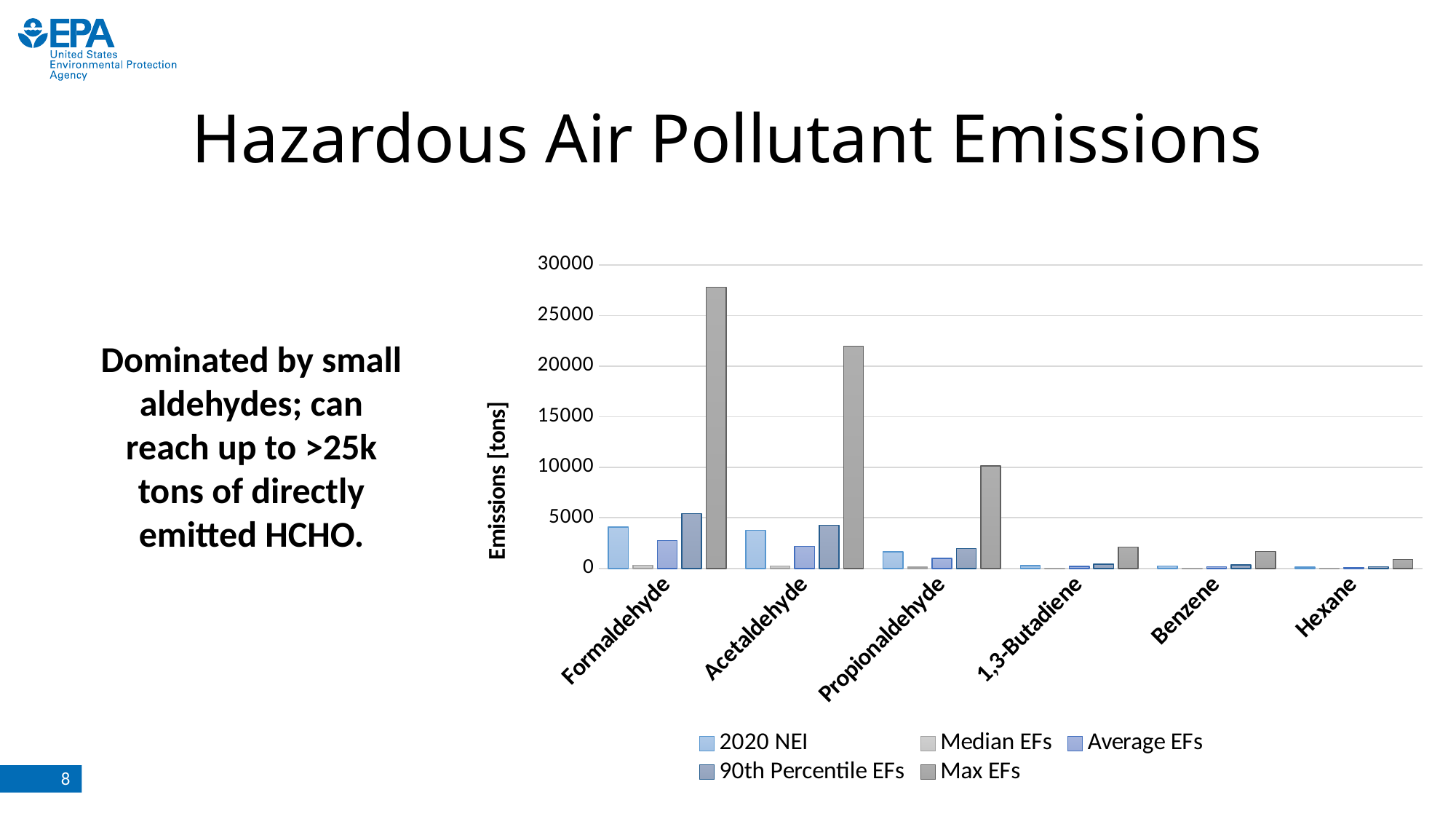
What kind of chart is shown on the slide? bar chart Which has the larger Max EFs value, Acetaldehyde or Propionaldehyde? Acetaldehyde For Formaldehyde, which is larger, the 90th Percentile EFs value or the 2020 NEI value? 90th Percentile EFs Is the Max EFs value for Propionaldehyde greater or less than 15000? less Which pollutant has the lowest Max EFs value? Hexane Is the Max EFs value for Acetaldehyde greater or less than 20000? greater Do the Max EFs values rise or fall moving from Formaldehyde to Hexane along the x axis? fall Is the 2020 NEI value for Formaldehyde greater or less than 5000? less Which pollutant has the highest Max EFs value? Formaldehyde How many pollutant categories are shown on the x axis of the chart? 6 How many series does the chart's legend list? 5